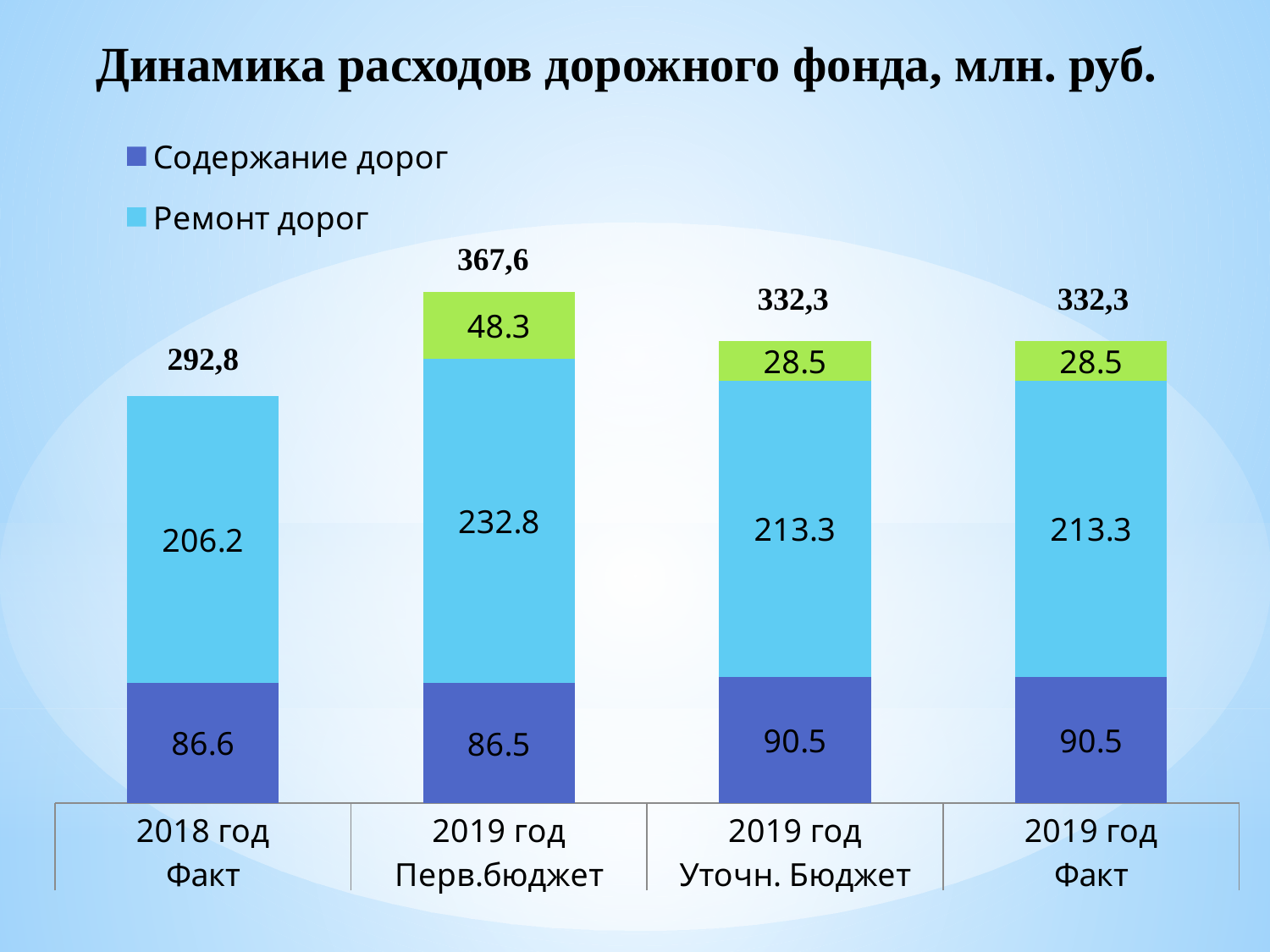
What is the difference between the Ремонт дорог values for 2019 год Перв.бюджет and 2019 год Факт? 19.5 What is the value of Содержание дорог for 2019 год Уточн. Бюджет? 90.5 Which category has the highest total? 2019 год Перв.бюджет Which category has the lowest total? 2018 год Факт What is the total printed above the stacked bar for 2019 год Перв.бюджет? 367,6 How many categories are shown on the x axis? 4 What is the value of Содержание дорог for 2018 год Факт? 86.6 How many series does the legend list? 2 Which is larger: Ремонт дорог for 2018 год Факт or Ремонт дорог for 2019 год Уточн. Бюджет? 2019 год Уточн. Бюджет What is the total printed above the stacked bar for 2018 год Факт? 292,8 What is the value of Ремонт дорог for 2019 год Перв.бюджет? 232.8 What is the value of Ремонт дорог for 2019 год Факт? 213.3